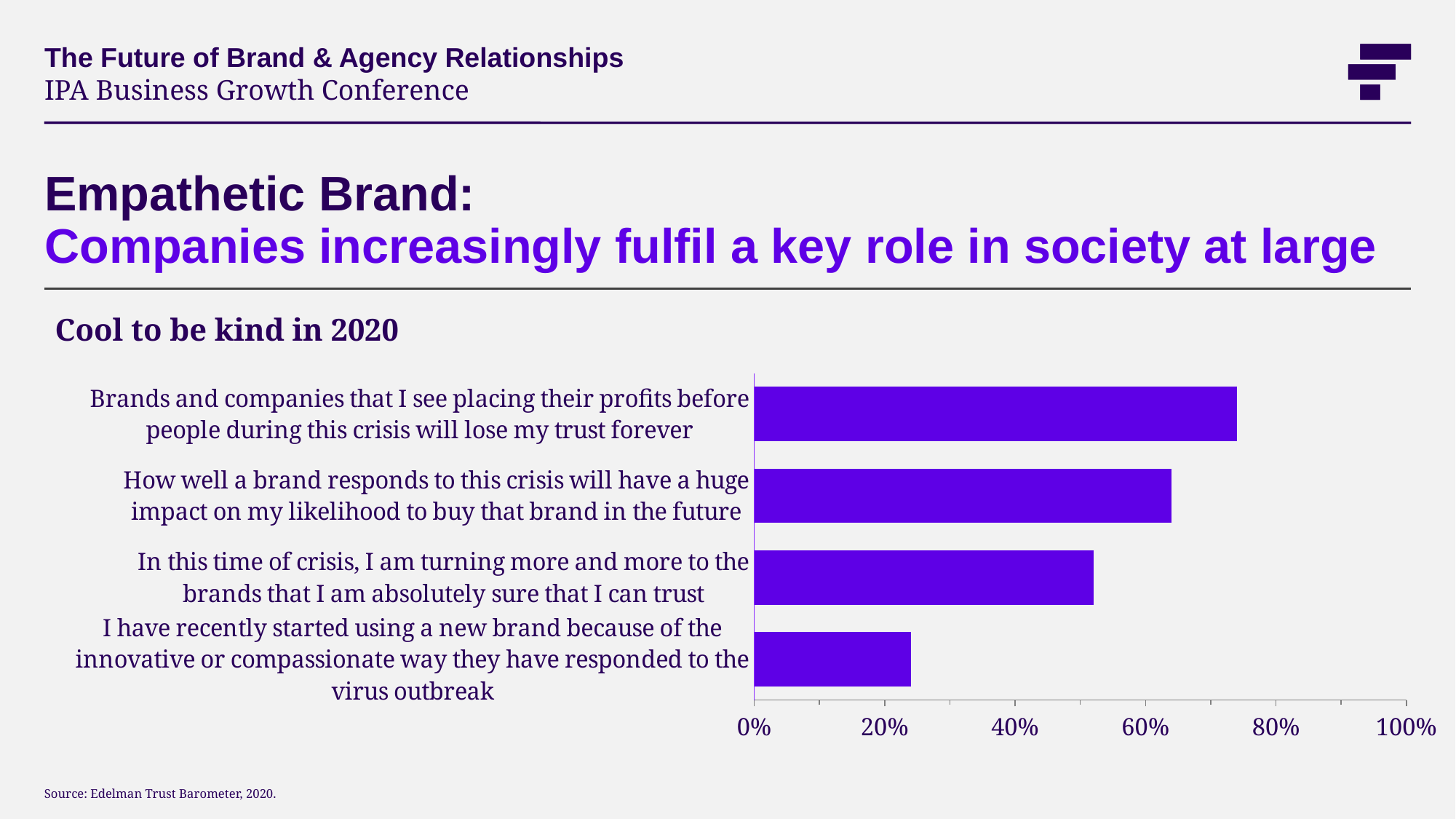
What is the maximum value shown on the chart's horizontal axis? 100% Is the value for "I have recently started using a new brand because of the innovative or compassionate way they have responded to the virus outbreak" greater or less than 40%? less Is the value for "How well a brand responds to this crisis will have a huge impact on my likelihood to buy that brand in the future" greater or less than 60%? greater Which statement has the lowest value in the chart? I have recently started using a new brand because of the innovative or compassionate way they have responded to the virus outbreak Is the value for "In this time of crisis, I am turning more and more to the brands that I am absolutely sure that I can trust" greater or less than 40%? greater What is the title of the chart? Cool to be kind in 2020 Which is larger: the value for "How well a brand responds to this crisis will have a huge impact on my likelihood to buy that brand in the future" or the value for "In this time of crisis, I am turning more and more to the brands that I am absolutely sure that I can trust"? How well a brand responds to this crisis will have a huge impact on my likelihood to buy that brand in the future How many categories (statements) does the chart show? 4 Which statement has the highest value in the chart? Brands and companies that I see placing their profits before people during this crisis will lose my trust forever What kind of chart is shown on the slide? bar chart